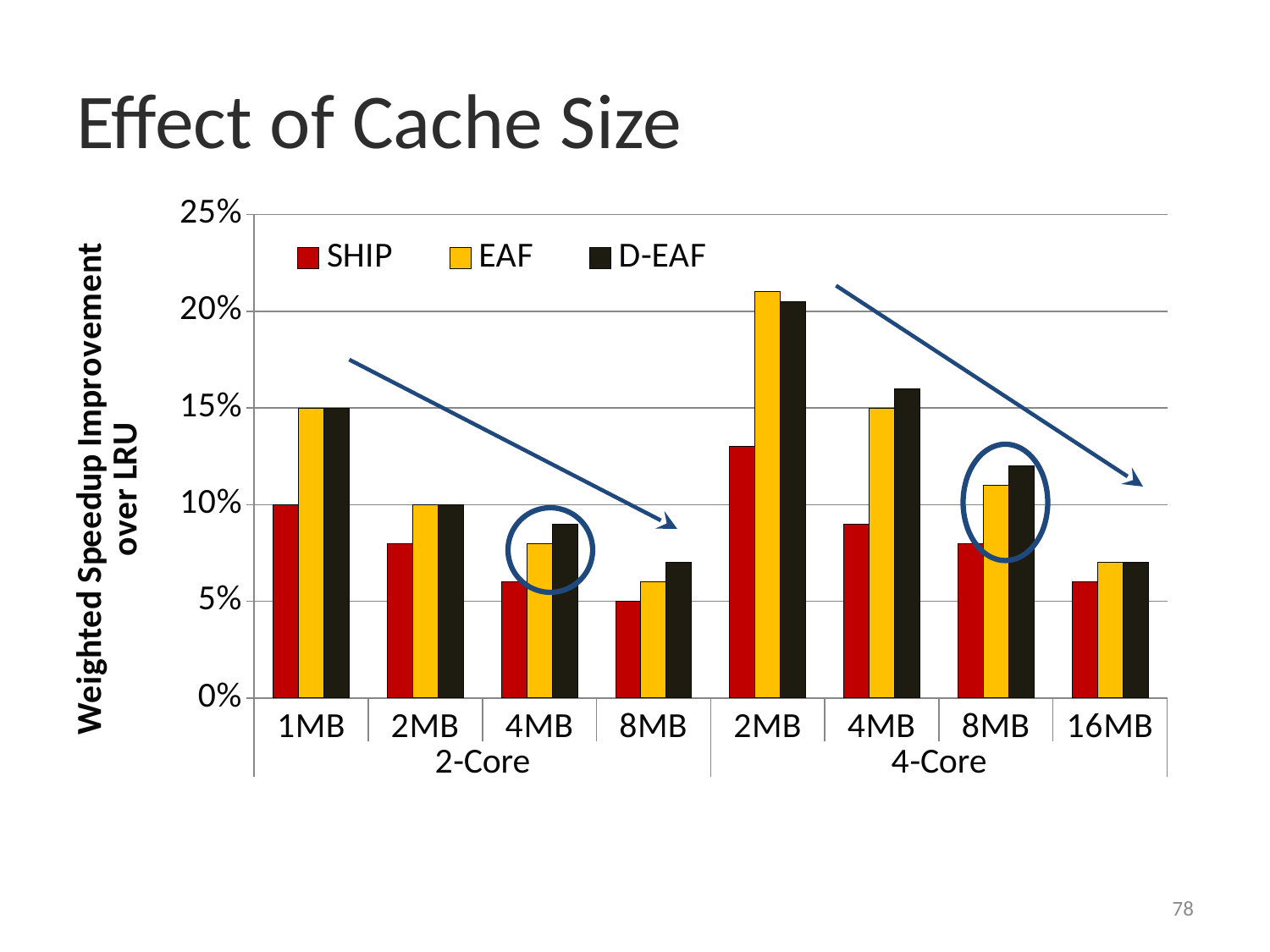
Within the 4-Core group, do the D-EAF values rise or fall as cache size increases from 2MB to 16MB? fall What is the y-axis label of the chart? Weighted Speedup Improvement over LRU Which cache size in the 4-Core group has the highest EAF value? 2MB Is the EAF value for 2MB in the 4-Core group greater or less than 20%? greater Which series is shown in red in the legend? SHIP How many cache-size categories are shown along the x axis? 8 What kind of chart is shown on the slide? bar chart How many series does the legend list? 3 What is the EAF value for 1MB in the 2-Core group? 15% Is the SHIP value for 8MB in the 4-Core group greater or less than 10%? less Which cache size in the 2-Core group has the lowest SHIP value? 8MB What is the SHIP value for 1MB in the 2-Core group? 10%